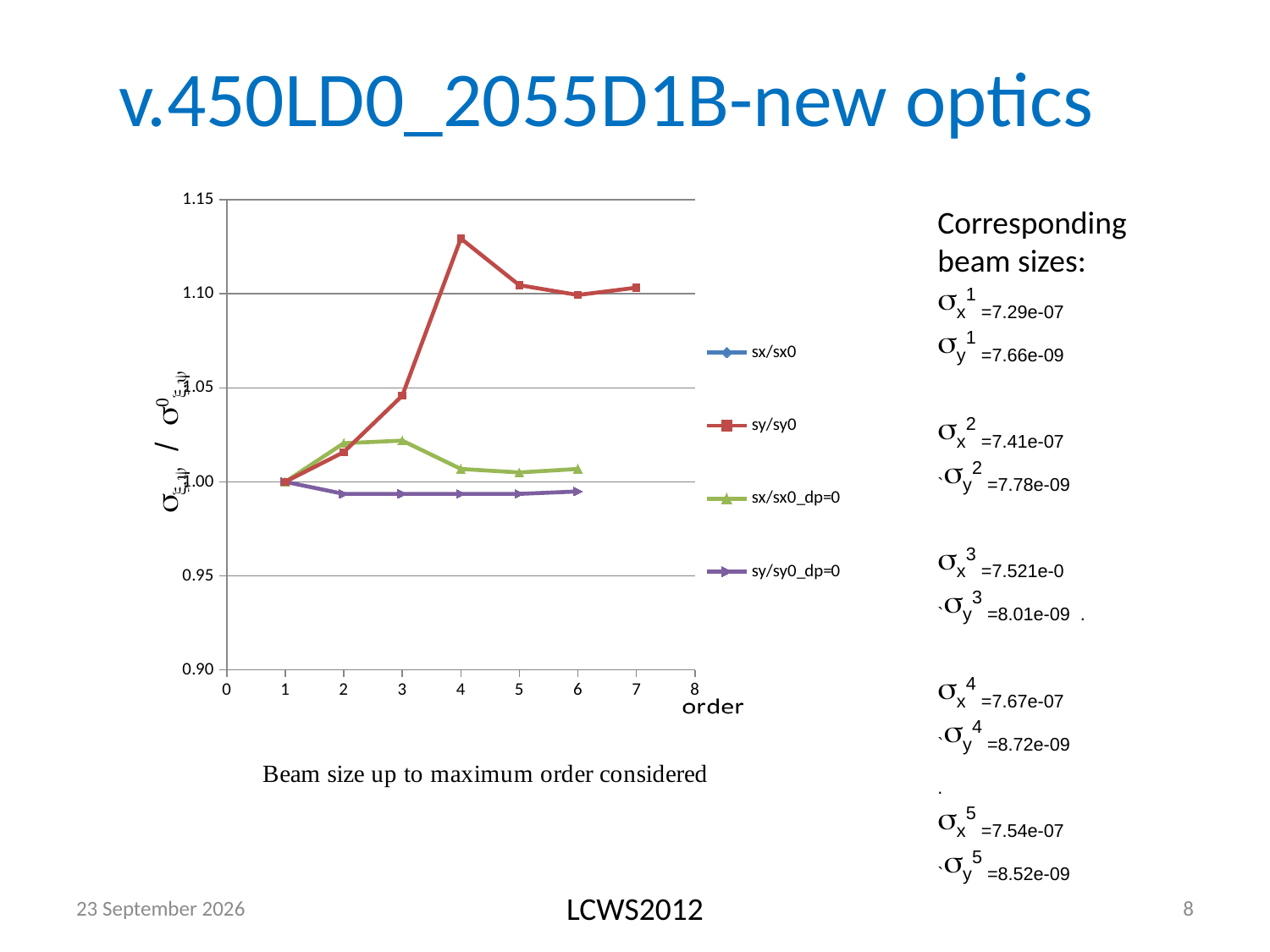
What are the series names listed in the chart legend? sx/sx0, sy/sy0, sx/sx0_dp=0, sy/sy0_dp=0 What is the title of the x axis of the chart? order Does the sy/sy0 series rise or fall between order 4 and order 6? fall Which series reaches the highest value on the chart? sy/sy0 How many data points are plotted for the sy/sy0 series? 7 Is the value of sy/sy0 at order 4 greater or less than 1.10? greater At order 6, which series has the larger value, sy/sy0 or sx/sx0_dp=0? sy/sy0 At which order does the sy/sy0 series reach its peak? 4 Is the value of sx/sx0_dp=0 at order 3 greater or less than 1.00? greater How many series does the chart legend list? 4 Is the value of sy/sy0 at order 2 greater or less than 1.05? less What kind of chart is shown on the slide? line chart